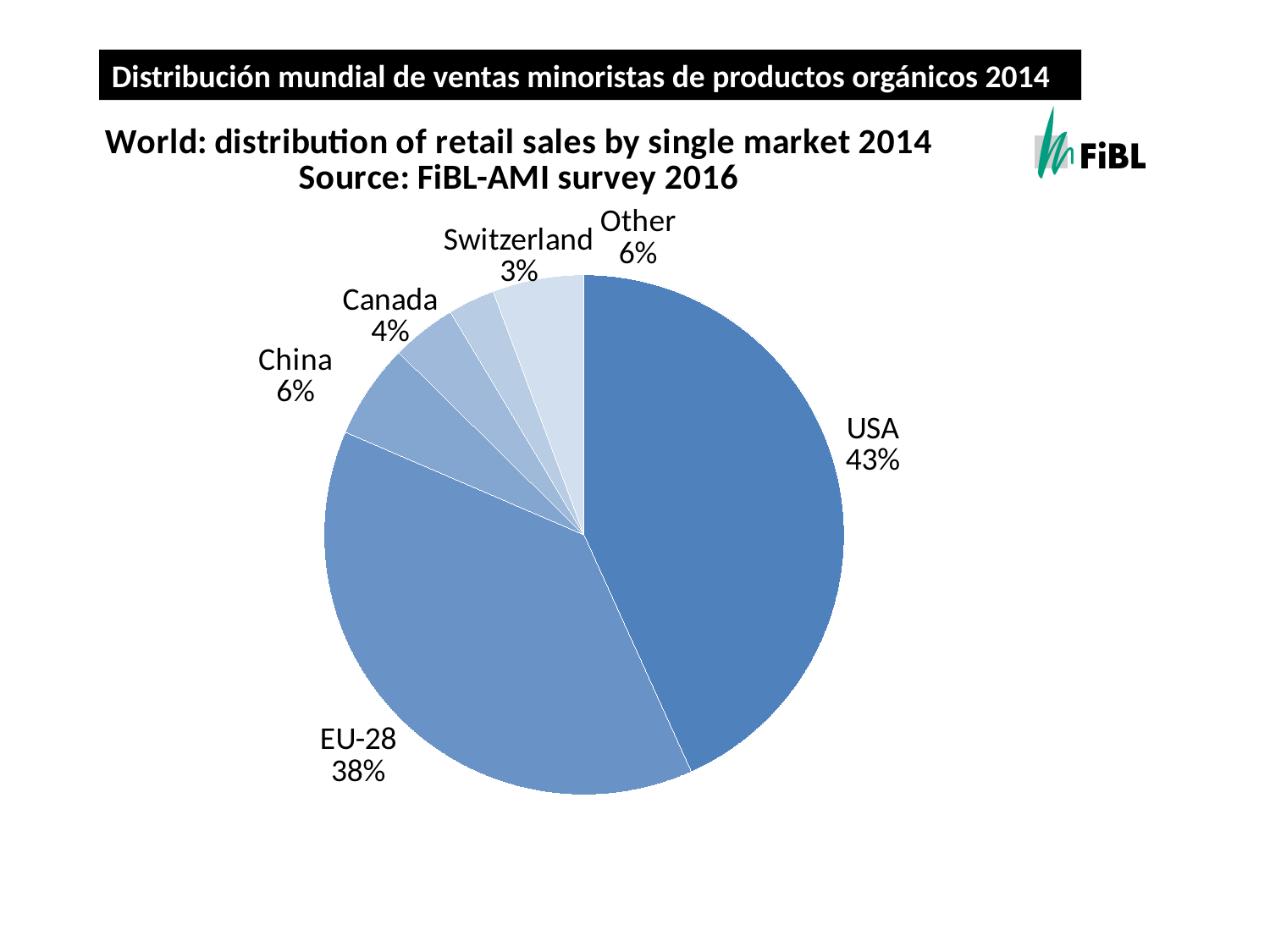
What is the difference in percentage points between the USA and EU-28 shares? 5 What share of retail sales does the EU-28 slice represent? 38% What share of retail sales does Canada represent? 4% What share of retail sales does Switzerland represent? 3% What kind of chart is shown on the slide? Pie chart Which market has the largest share of retail sales? USA What share of retail sales does China represent? 6% Which market has the smallest share of retail sales? Switzerland What is the source given in the chart title? FiBL-AMI survey 2016 How many slices does the pie chart have? 6 What share of retail sales does the USA slice represent? 43% Which has a larger share, China or Canada? China